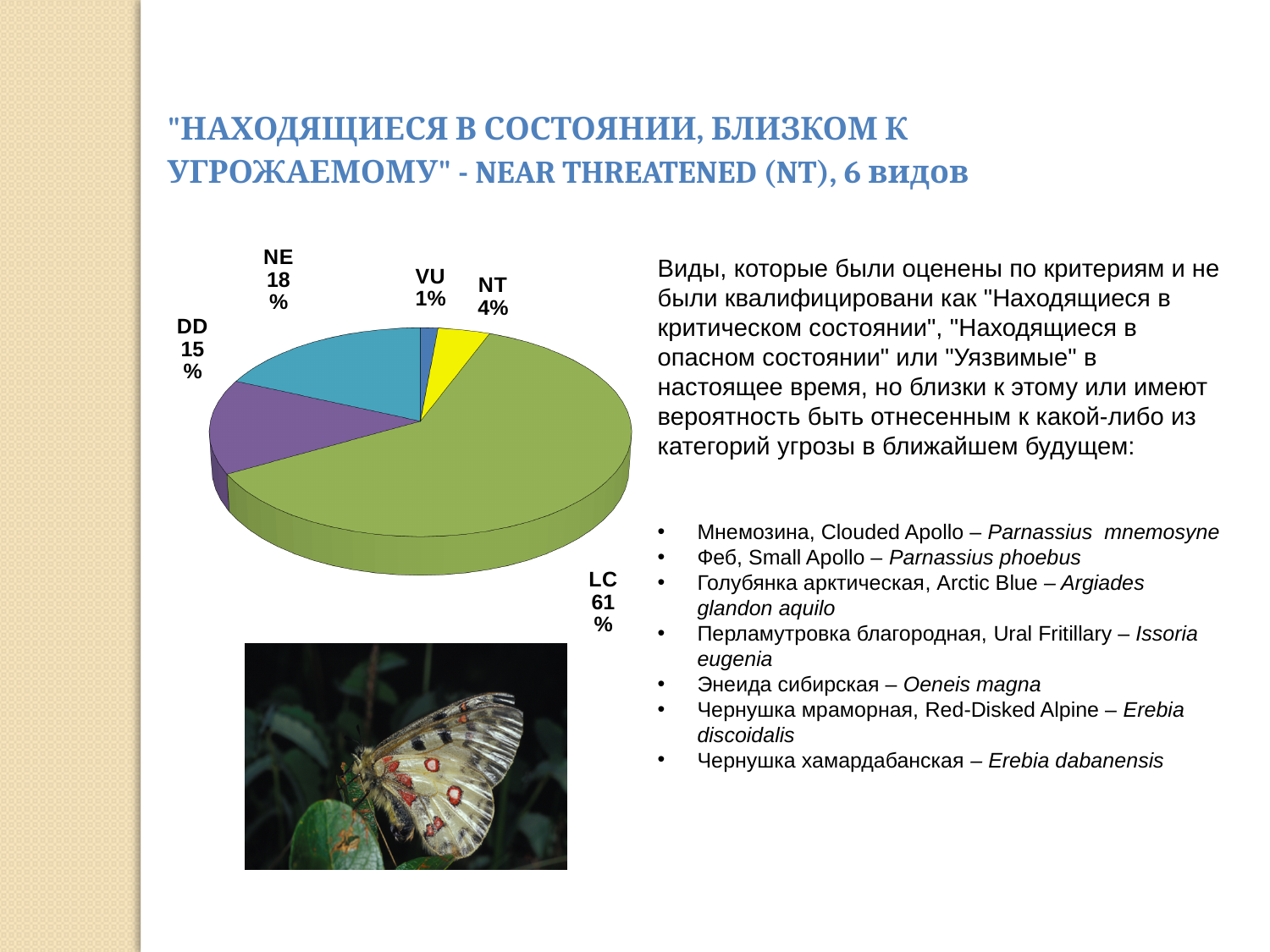
What is the value shown for DD in the pie chart? 15% Which category has the smallest slice in the pie chart? VU What is the value shown for VU in the pie chart? 1% What colour is the LC slice in the pie chart? green How many slices does the pie chart have? 5 What is the value shown for NE in the pie chart? 18% What share of the pie does the LC slice represent? 61% What is the value shown for NT in the pie chart? 4% What is the difference between the NE and DD shares in the pie chart? 3% Which is larger in the pie chart, the NT slice or the DD slice? DD Which category has the largest slice in the pie chart? LC What kind of chart is shown on the slide? pie chart